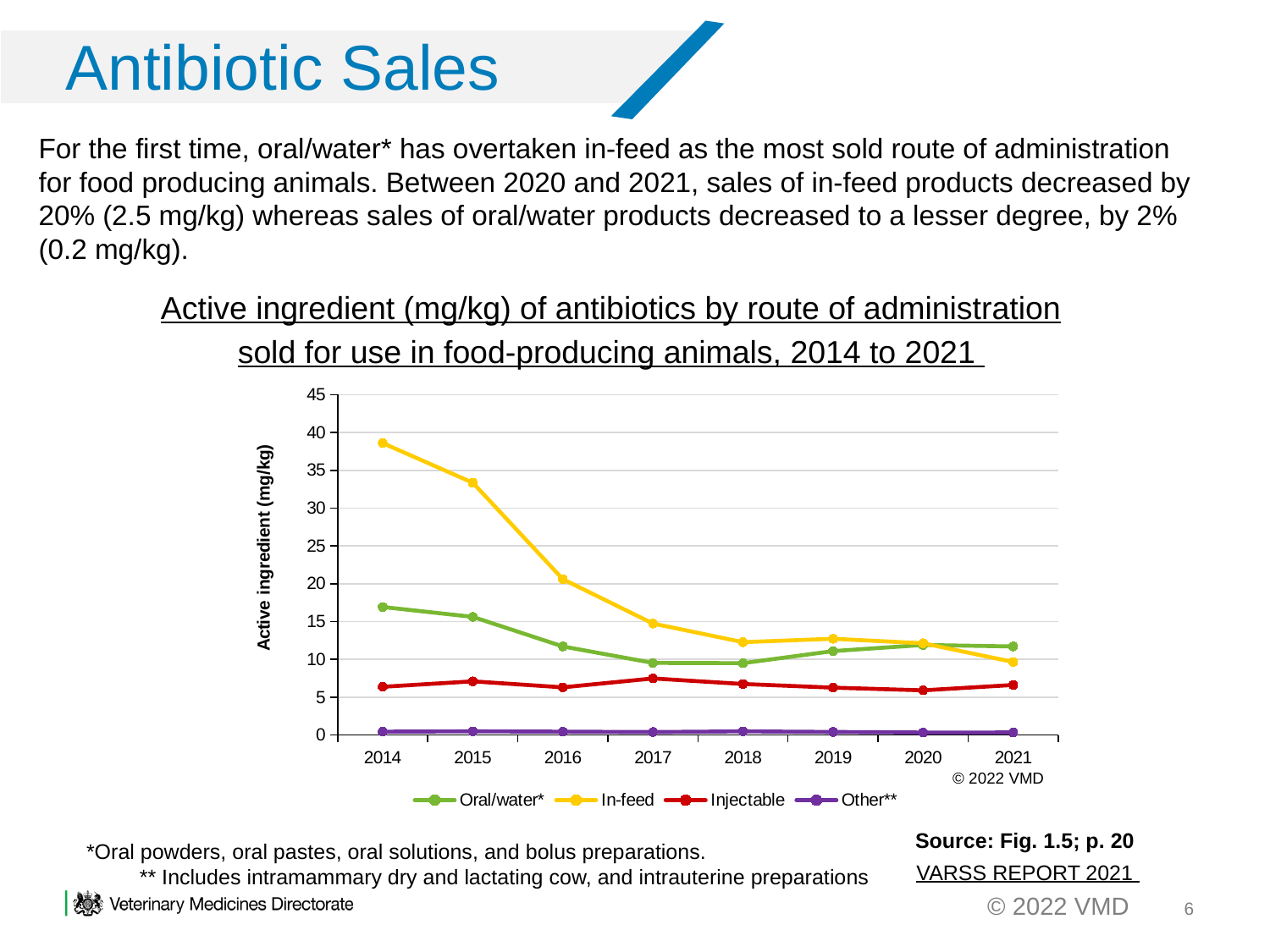
What colour is the In-feed line in the legend? Yellow Is the Oral/water* value for 2014 greater or less than 15? greater How many series does the legend list? 4 Is the In-feed value for 2014 greater or less than 35? greater Is the Injectable value for 2014 greater or less than 10? less How many years are plotted along the x axis? 8 In 2014, which is larger: In-feed or Oral/water*? In-feed Which route of administration has the lowest values across all years? Other** In 2021, which is larger: Oral/water* or In-feed? Oral/water* What kind of chart is shown on the slide? Line chart Which route of administration had the highest value in 2014? In-feed Does the In-feed line rise or fall from 2014 to 2021? Fall